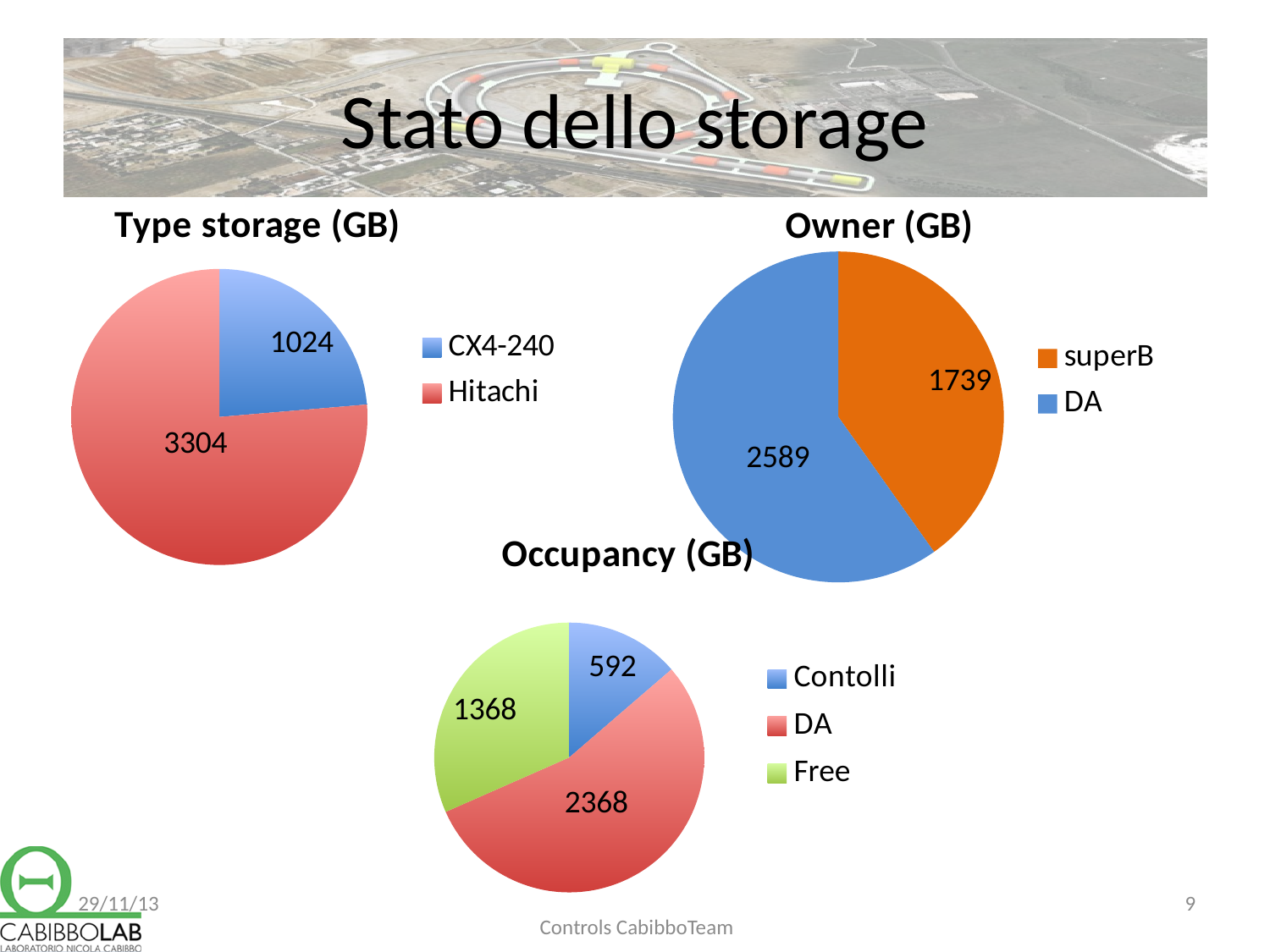
In the 'Owner (GB)' chart, what is the difference between DA and superB? 850 In the 'Owner (GB)' chart, which owner has the larger value, superB or DA? DA In the 'Occupancy (GB)' chart, which category has the smallest value? Contolli In the 'Owner (GB)' chart, what is the value for superB? 1739 What kind of chart is the 'Occupancy (GB)' chart? Pie chart In the 'Occupancy (GB)' chart, what is the value for Free? 1368 In the 'Type storage (GB)' chart, what is the difference between Hitachi and CX4-240? 2280 In the 'Occupancy (GB)' chart, how many categories are shown? 3 In the 'Type storage (GB)' chart, what is the value for Hitachi? 3304 In the 'Occupancy (GB)' chart, which category has the largest value? DA In the 'Type storage (GB)' chart, what is the value for CX4-240? 1024 In the 'Occupancy (GB)' chart, what is the total of all three slices? 4328